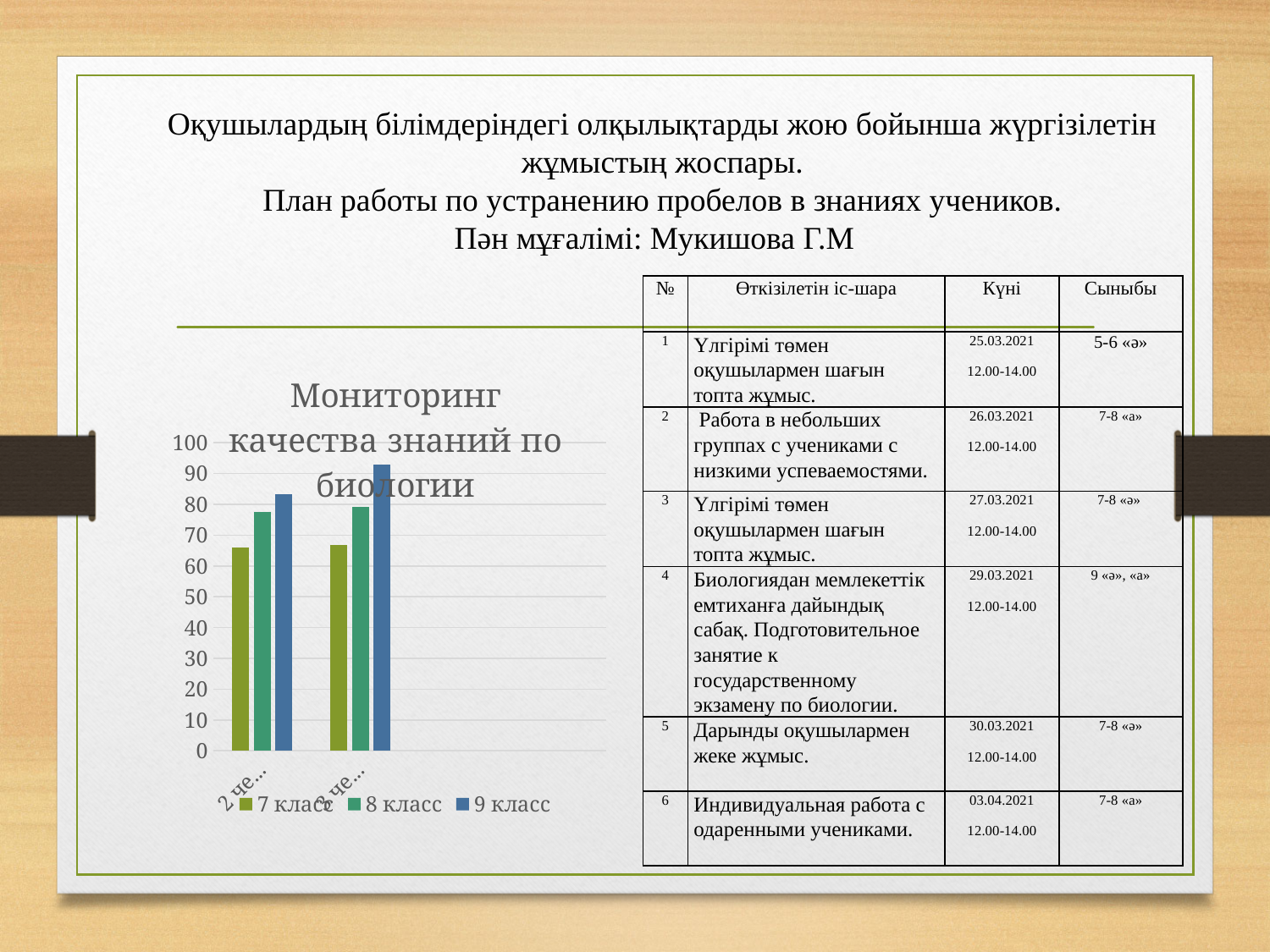
What kind of chart is shown on the slide? bar chart What is the title of the chart on the slide? Мониторинг качества знаний по биологии Does the value for 9 класс rise or fall from the first category group to the second? rise How many category groups are plotted on the x axis of the chart? 2 Is the value for 7 класс in the first category group greater or less than 70? less Is the value for 8 класс in the first category group greater or less than 70? greater How many series does the chart legend list? 3 In the first category group, is the bar for 9 класс larger or smaller than the bar for 7 класс? larger Which series are listed in the chart legend? 7 класс, 8 класс, 9 класс In the second category group, which series has the shortest bar? 7 класс Is the value for 9 класс in the second category group greater or less than 80? greater In the first category group, which series has the tallest bar? 9 класс